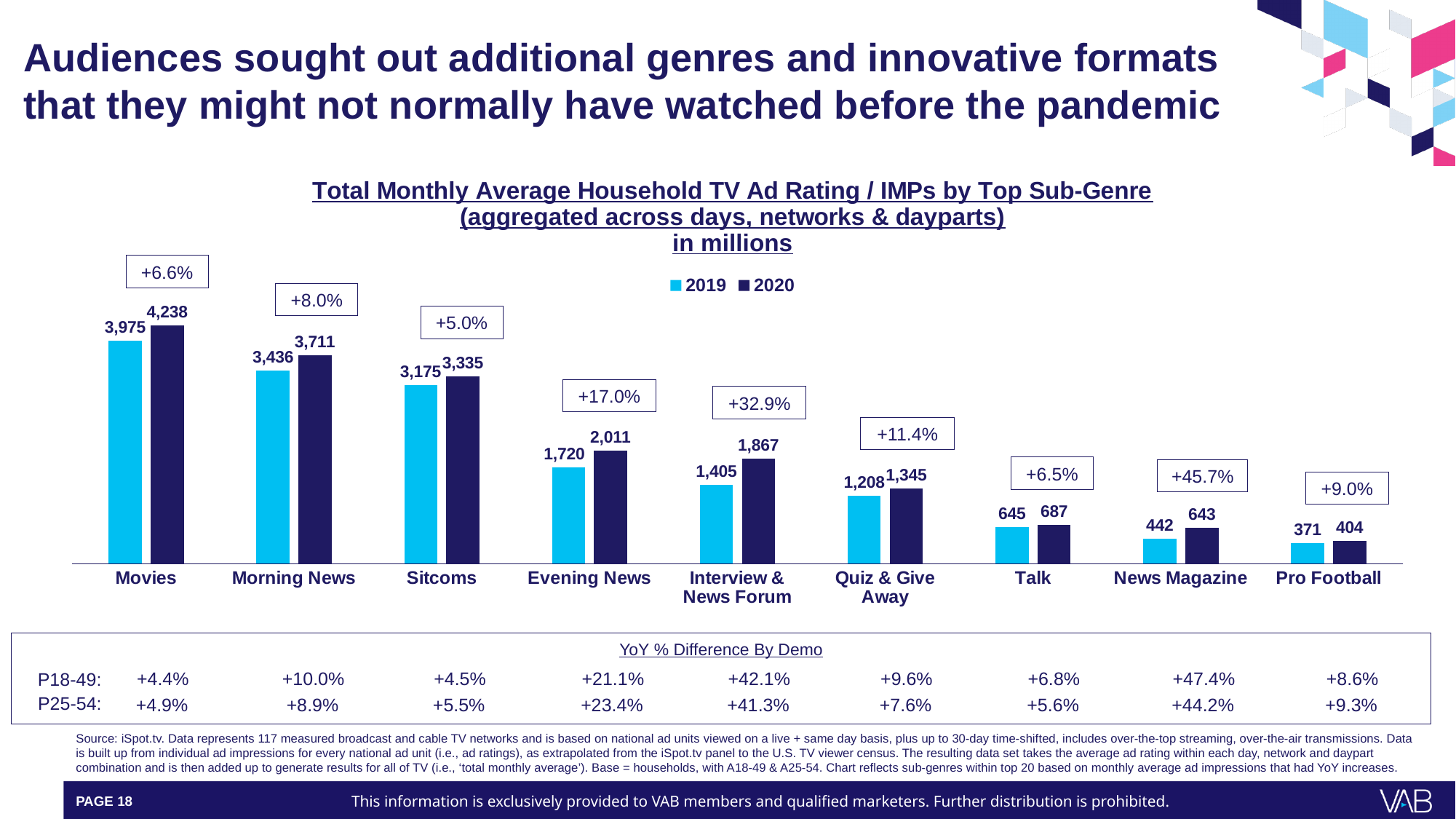
How many series does the legend list? 2 How many sub-genres are shown on the x axis? 9 What is the 2019 value for Interview & News Forum? 1,405 What is the 2019 value for Pro Football? 371 What is the 2020 value for Movies? 4,238 What percentage change is shown in the box above the News Magazine bars? +45.7% Which is larger: the 2020 value for Talk or the 2020 value for News Magazine? Talk What kind of chart is shown on the slide? Bar chart Which sub-genre has the highest 2020 value? Movies Which sub-genre has the lowest 2019 value? Pro Football Do the 2019 values rise or fall moving from Movies to Pro Football along the x axis? Fall What is the difference between the 2020 and 2019 values for Evening News? 291